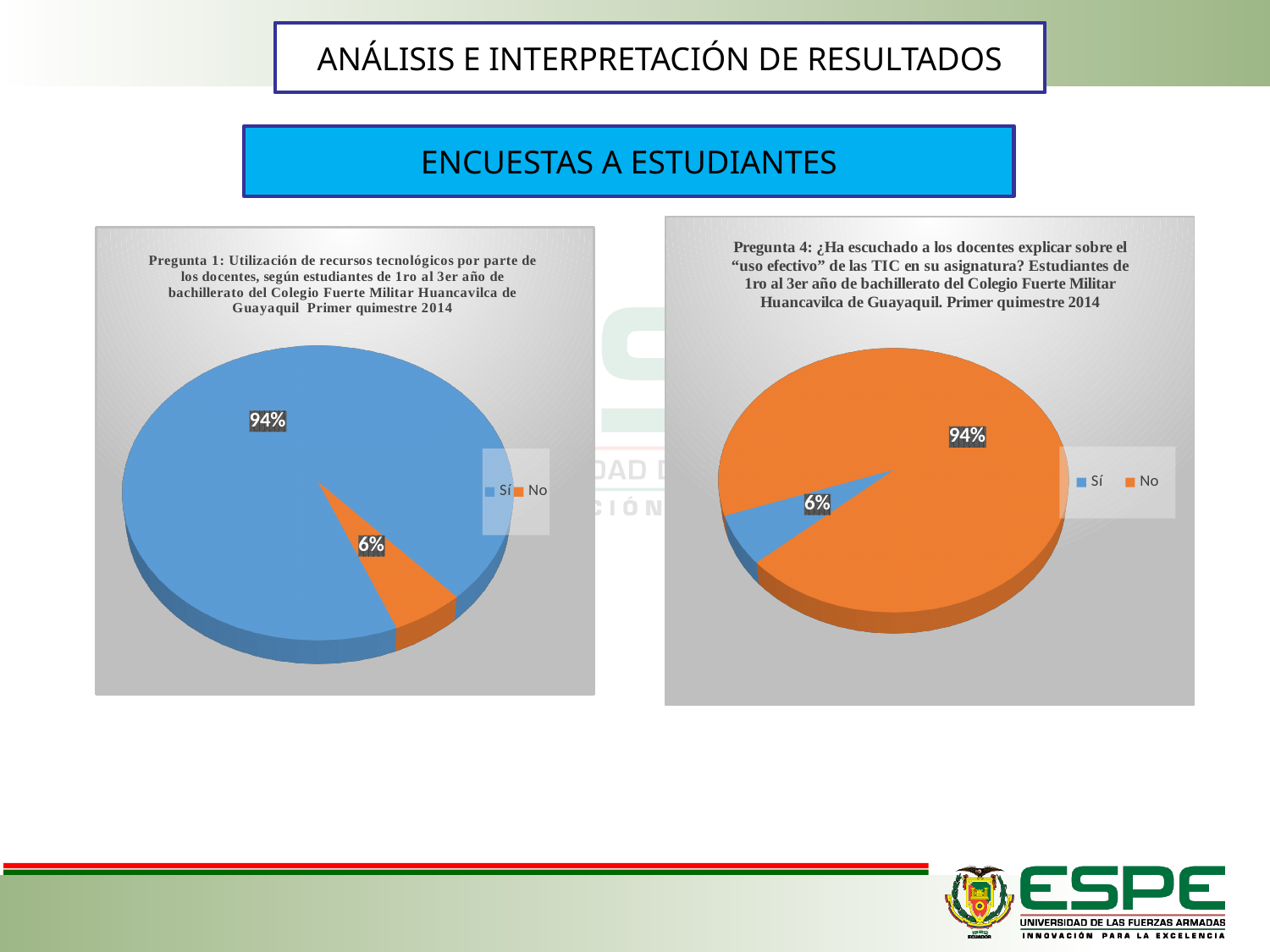
In the right chart (Pregunta 4), what percentage of students answered "No"? 94% In the left chart (Pregunta 1), what percentage of students answered "Sí"? 94% In the left chart (Pregunta 1), which response has the largest share? Sí In the left chart (Pregunta 1), what percentage of students answered "No"? 6% How many slices does the right chart (Pregunta 4) have? 2 In the left chart (Pregunta 1), what is the difference in percentage points between the "Sí" and "No" slices? 88 How many entries does the legend of the left chart (Pregunta 1) list? 2 What type of chart is used for Pregunta 1 on the left? Pie chart In the right chart (Pregunta 4), what colour is the "No" slice? Orange In the right chart (Pregunta 4), what percentage of students answered "Sí"? 6% In the right chart (Pregunta 4), which response has the smallest share? Sí In the right chart (Pregunta 4), which is larger, the "Sí" slice or the "No" slice? No